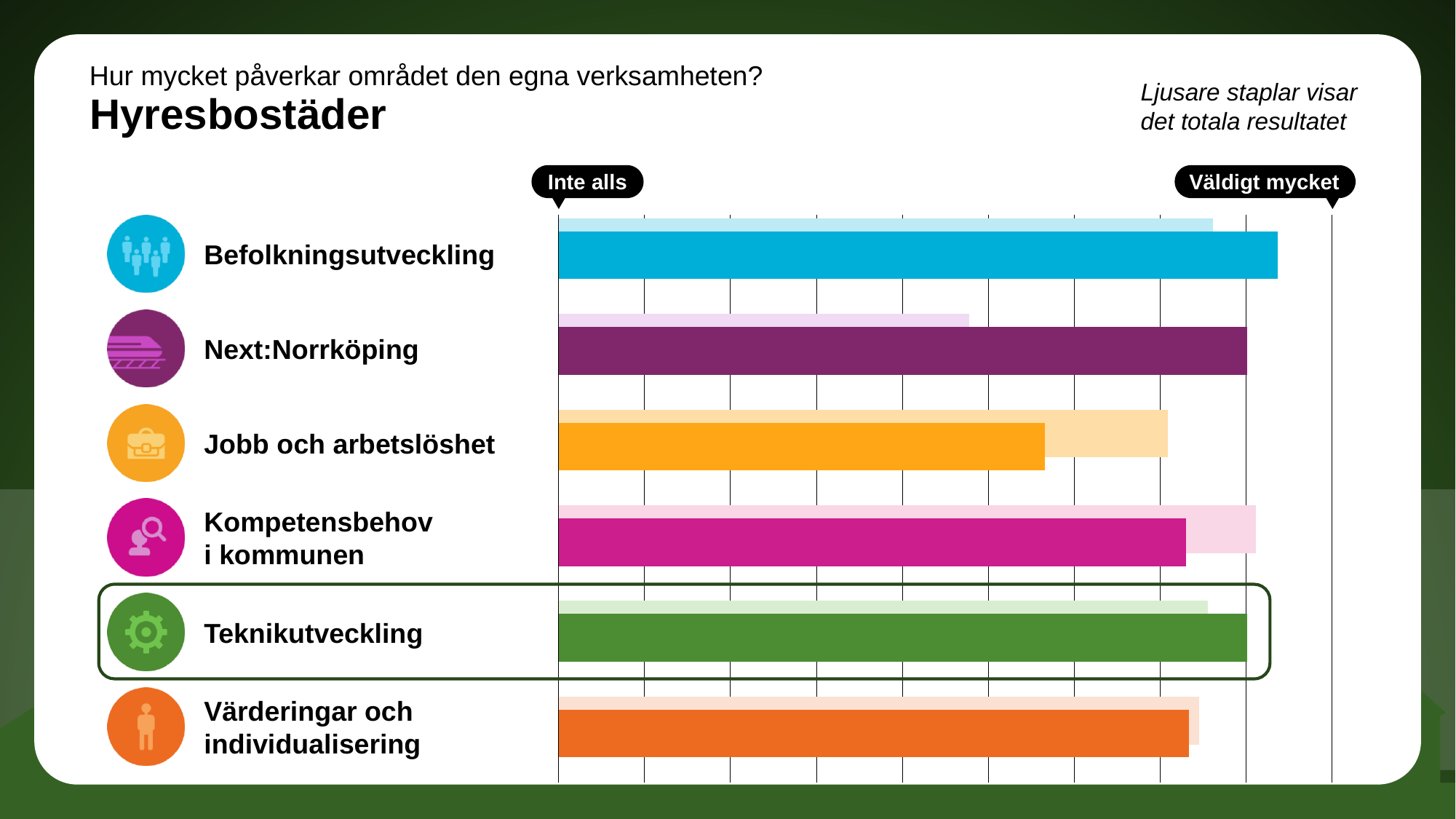
For Next:Norrköping, is the dark bar longer or shorter than the light bar? Longer Which has the longer dark bar: Befolkningsutveckling or Jobb och arbetslöshet? Befolkningsutveckling Which category has the longest light bar (the total result)? Kompetensbehov i kommunen Which category has the longest dark bar (the Hyresbostäder result)? Befolkningsutveckling What are the two labels at the ends of the chart's scale? Inte alls and Väldigt mycket What kind of chart is shown on the slide? Bar chart For Jobb och arbetslöshet, is the dark bar longer or shorter than the light bar? Shorter Which category has the shortest light bar (the total result)? Next:Norrköping How many categories (areas) are shown in the chart? 6 Which category has the shortest dark bar (the Hyresbostäder result)? Jobb och arbetslöshet What do the lighter bars in the chart represent, according to the note on the slide? Det totala resultatet